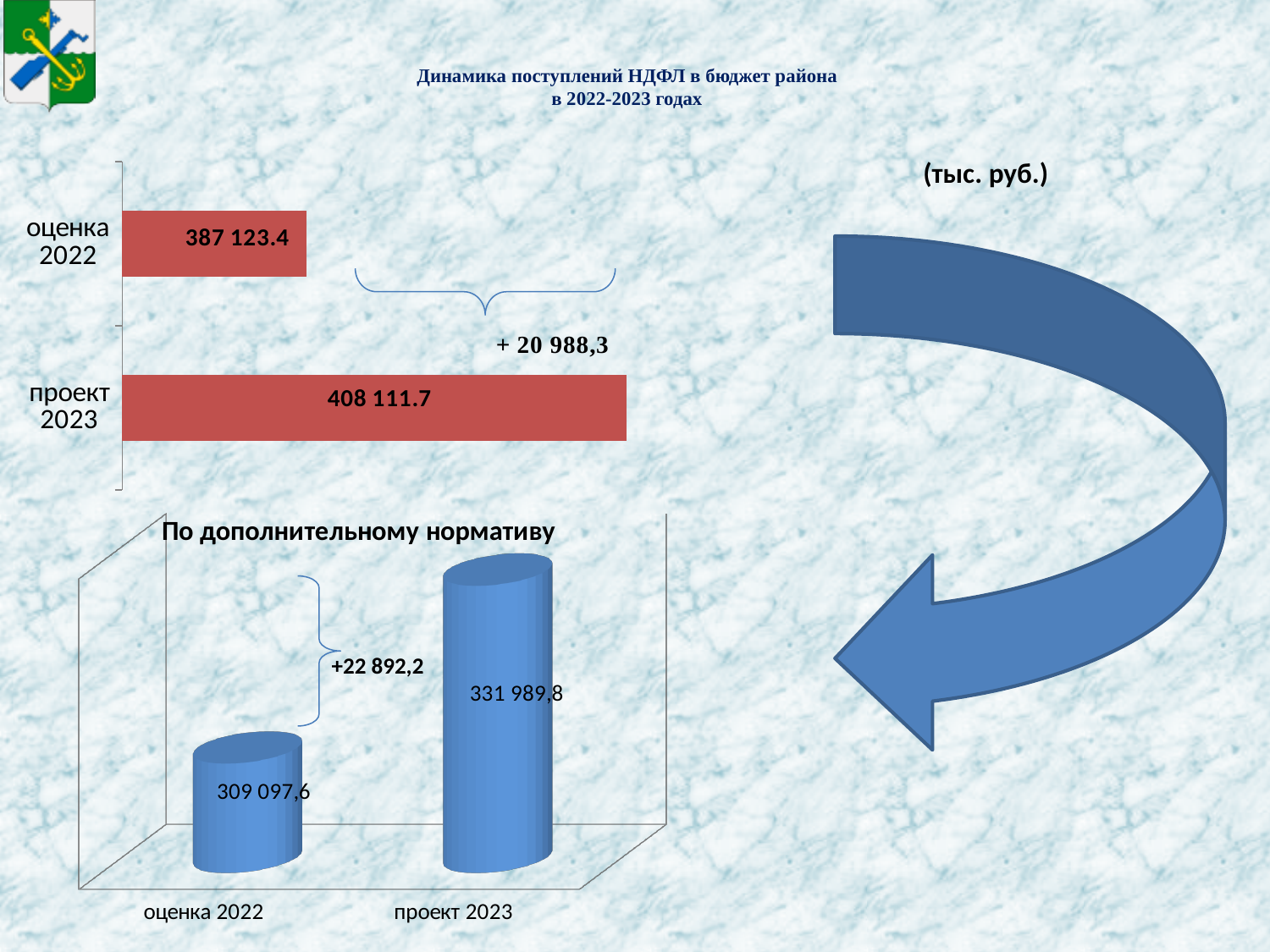
In the top bar chart, what is the value for проект 2023? 408 111.7 In the chart titled 'По дополнительному нормативу', by how much does проект 2023 exceed оценка 2022? 22 892,2 In the chart titled 'По дополнительному нормативу', which category has the lower value? оценка 2022 In the top bar chart, what is the value for оценка 2022? 387 123.4 In the chart titled 'По дополнительному нормативу', what is the value for проект 2023? 331 989,8 What kind of chart is the top chart? bar chart In the chart titled 'По дополнительному нормативу', do the values rise or fall from оценка 2022 to проект 2023? rise What is the title of the bottom chart? По дополнительному нормативу In the chart titled 'По дополнительному нормативу', what is the value for оценка 2022? 309 097,6 In the top bar chart, what is the difference between проект 2023 and оценка 2022? 20 988,3 In the top bar chart, which category has the higher value? проект 2023 How many bars does the top chart show? 2